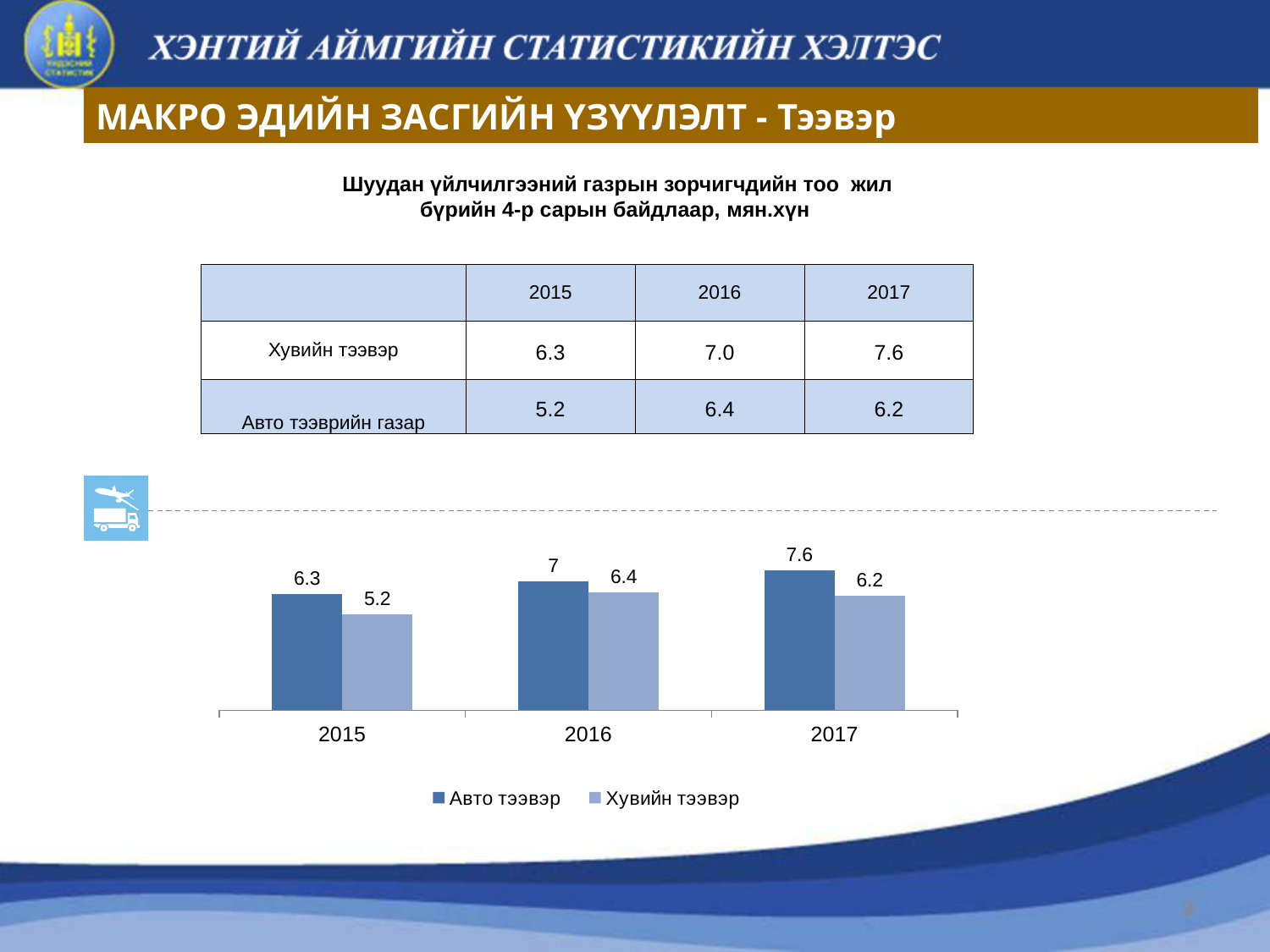
Which is larger in the chart for 2016: the Авто тээвэр bar or the Хувийн тээвэр bar? Авто тээвэр What is the value of the Авто тээвэр bar for 2015 in the chart? 6.3 What is the value of the Хувийн тээвэр bar for 2016 in the chart? 6.4 What is the value of the Авто тээвэр bar for 2017 in the chart? 7.6 What is the value of the Хувийн тээвэр bar for 2015 in the chart? 5.2 What is the difference between the Авто тээвэр and Хувийн тээвэр bars for 2017 in the chart? 1.4 How many year categories are shown on the chart's x axis? 3 What type of chart is shown on the slide? bar chart Does the Авто тээвэр series rise or fall from 2015 to 2017 in the chart? rise In which year is the Авто тээвэр bar highest in the chart? 2017 How many series does the chart legend list? 2 In which year is the Хувийн тээвэр bar lowest in the chart? 2015